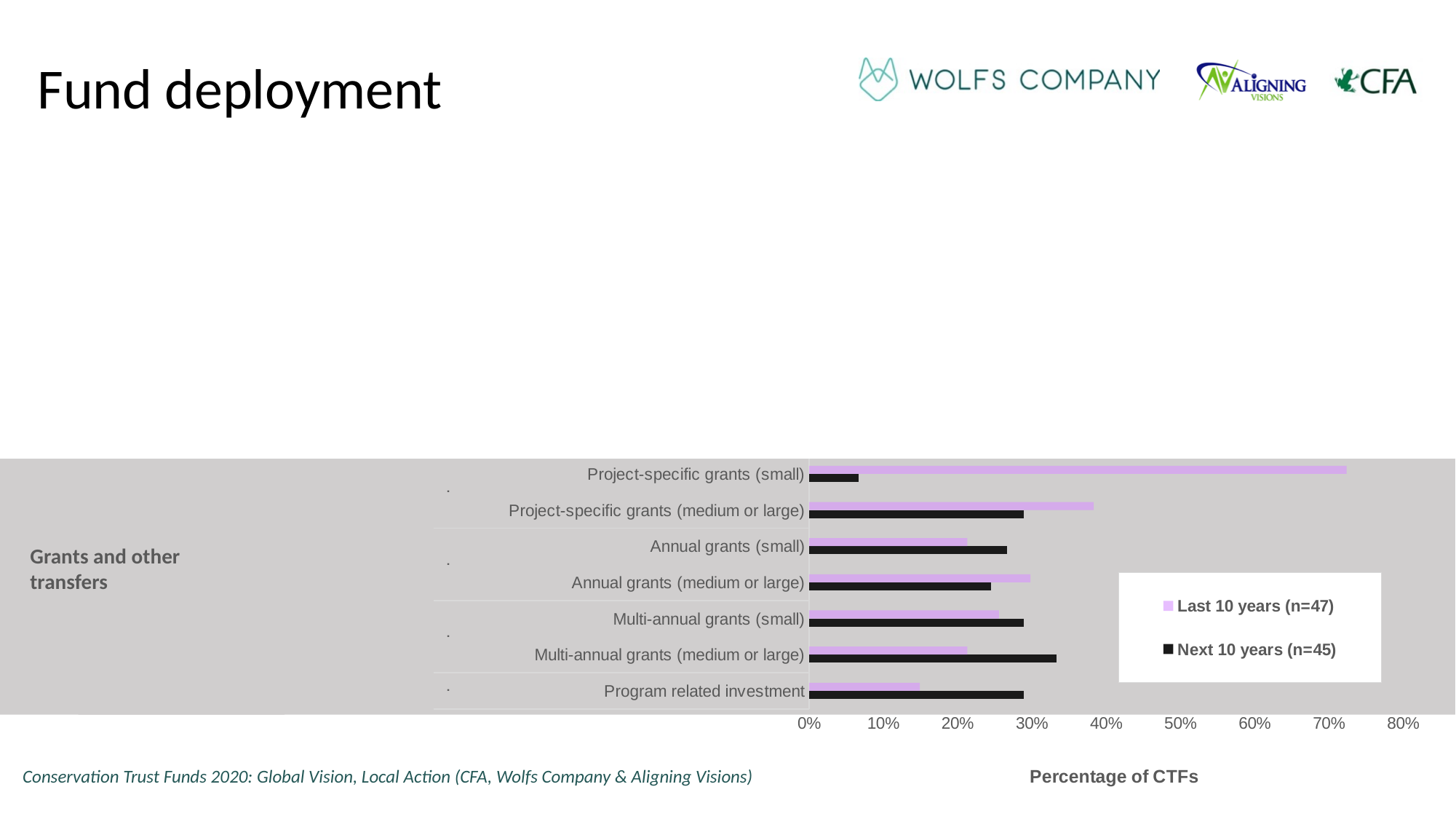
How many categories are plotted on the chart? 7 Which category has the lowest value for Last 10 years (n=47)? Program related investment How many series does the legend list? 2 Is the value for Project-specific grants (small) in Last 10 years (n=47) greater or less than 70%? greater What kind of chart is shown on the slide? Bar chart Which category has the highest value for Last 10 years (n=47)? Project-specific grants (small) For Project-specific grants (medium or large), which series has the larger value: Last 10 years (n=47) or Next 10 years (n=45)? Last 10 years (n=47) Is the value for Project-specific grants (small) in Next 10 years (n=45) greater or less than 10%? less Is the value for Program related investment in Last 10 years (n=47) greater or less than 20%? less For Program related investment, which series has the larger value: Last 10 years (n=47) or Next 10 years (n=45)? Next 10 years (n=45) What is the label of the horizontal axis? Percentage of CTFs Which category has the lowest value for Next 10 years (n=45)? Project-specific grants (small)